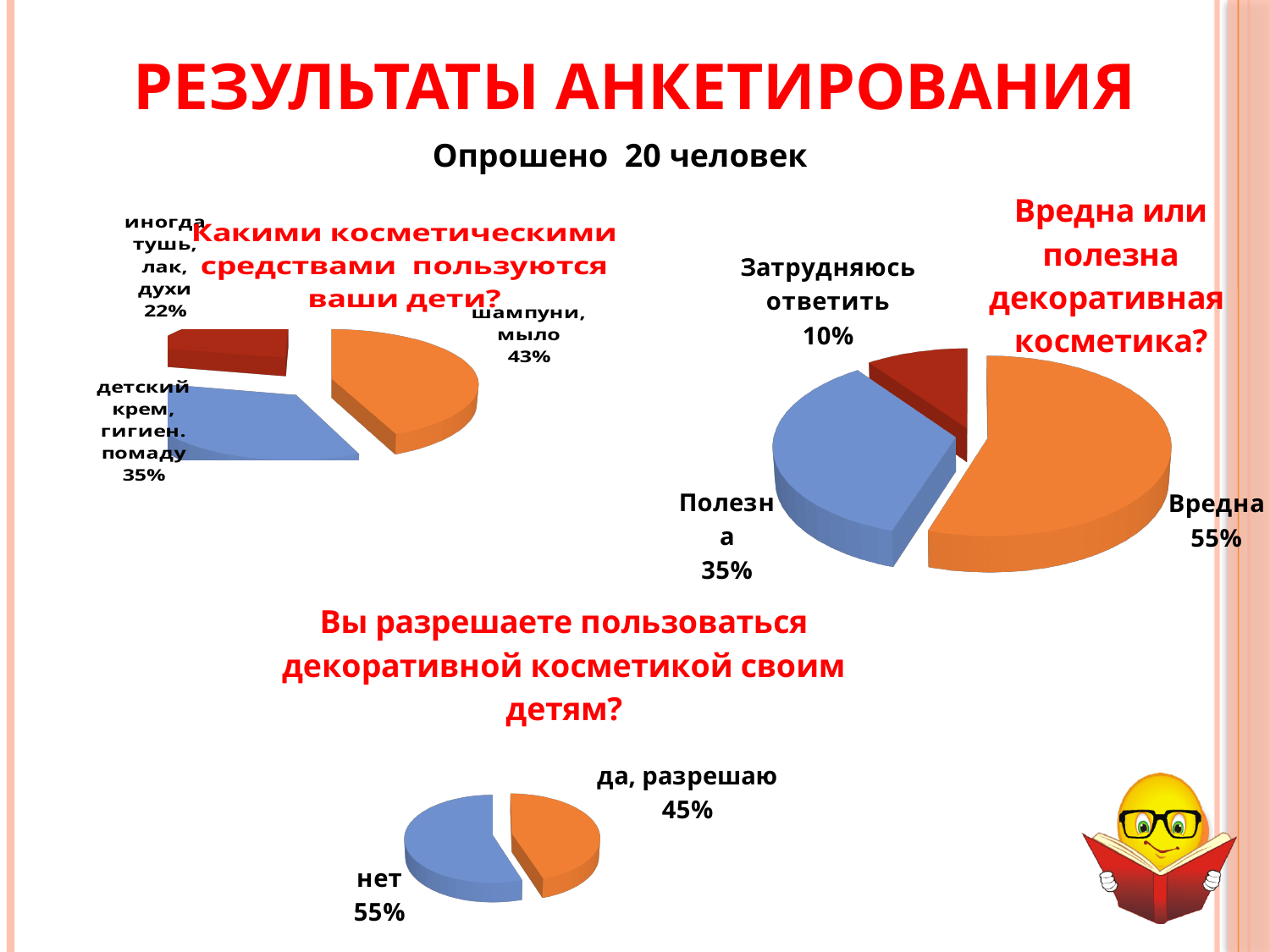
In the chart 'Какими косметическими средствами пользуются ваши дети?', which category has the largest share? шампуни, мыло In the chart 'Вы разрешаете пользоваться декоративной косметикой своим детям?', what share answered 'нет'? 55% In the chart 'Какими косметическими средствами пользуются ваши дети?', what share is shown for 'иногда тушь, лак, духи'? 22% In the chart 'Какими косметическими средствами пользуются ваши дети?', how many slices does the pie have? 3 What type of chart is used for 'Вы разрешаете пользоваться декоративной косметикой своим детям?' Pie chart In the chart 'Вредна или полезна декоративная косметика?', what share of respondents answered 'Вредна'? 55% How many people were surveyed according to the slide? 20 In the chart 'Вредна или полезна декоративная косметика?', which answer has the smallest share? Затрудняюсь ответить In the chart 'Какими косметическими средствами пользуются ваши дети?', what share is shown for 'шампуни, мыло'? 43% In the chart 'Вредна или полезна декоративная косметика?', what share of respondents answered 'Затрудняюсь ответить'? 10% In the chart 'Вредна или полезна декоративная косметика?', what is the difference between the shares for 'Вредна' and 'Полезна'? 20% In the chart 'Вы разрешаете пользоваться декоративной косметикой своим детям?', which answer is larger, 'да, разрешаю' or 'нет'? нет